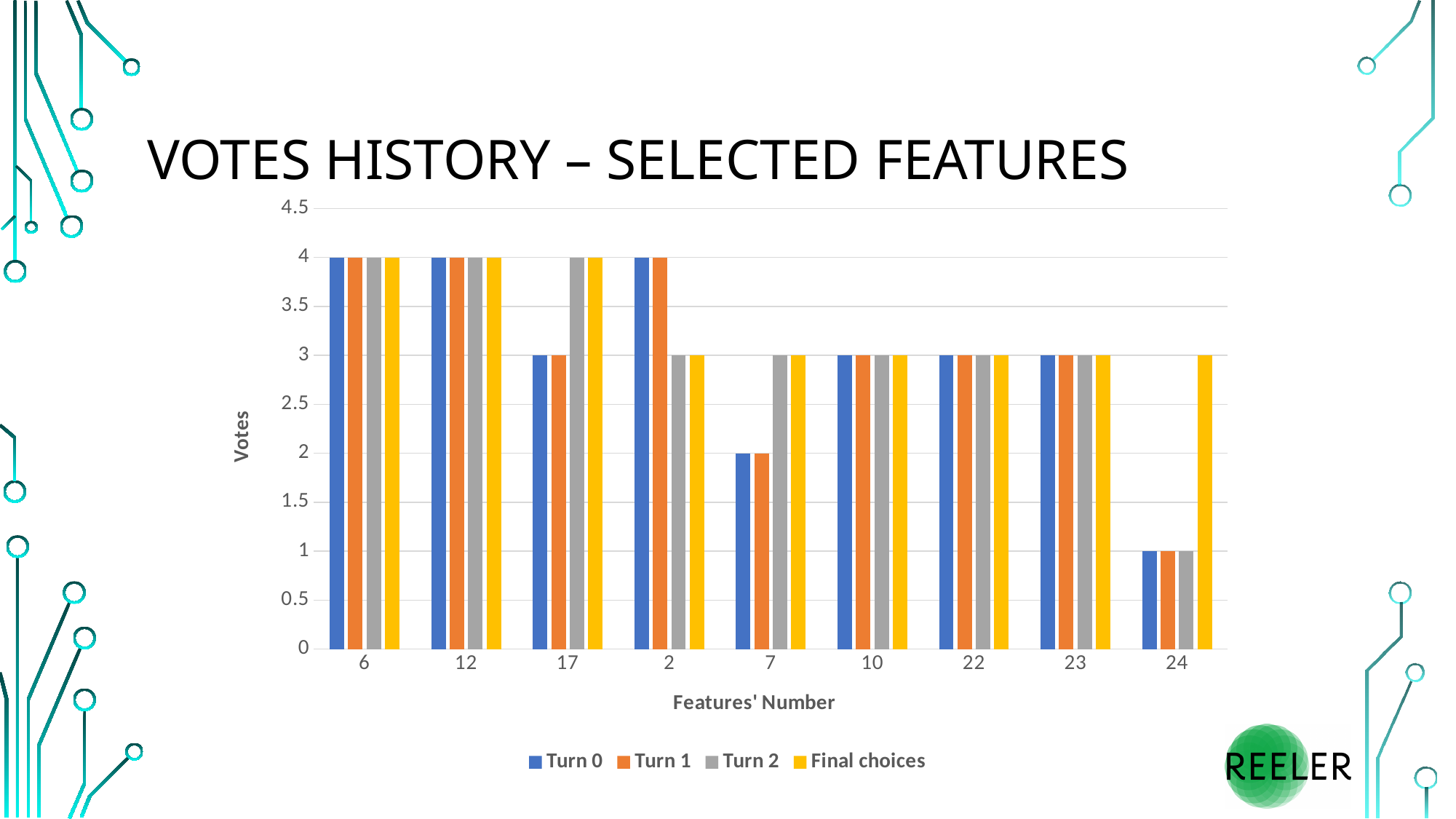
What is the Turn 2 value for feature 17? 4 What is the Final choices value for feature 24? 3 What is the difference between the Final choices value and the Turn 0 value for feature 24? 2 What is the Turn 1 value for feature 2? 4 Which feature number has the lowest Turn 0 value? 24 What kind of chart is shown on the slide? bar chart How many series does the legend list? 4 Is the Turn 2 value for feature 2 greater or less than 3.5? less What is the title of the chart's x axis? Features' Number For feature 7, which is larger: the Turn 0 value or the Turn 2 value? Turn 2 What is the Turn 0 value for feature 7? 2 How many feature numbers are shown on the x axis? 9